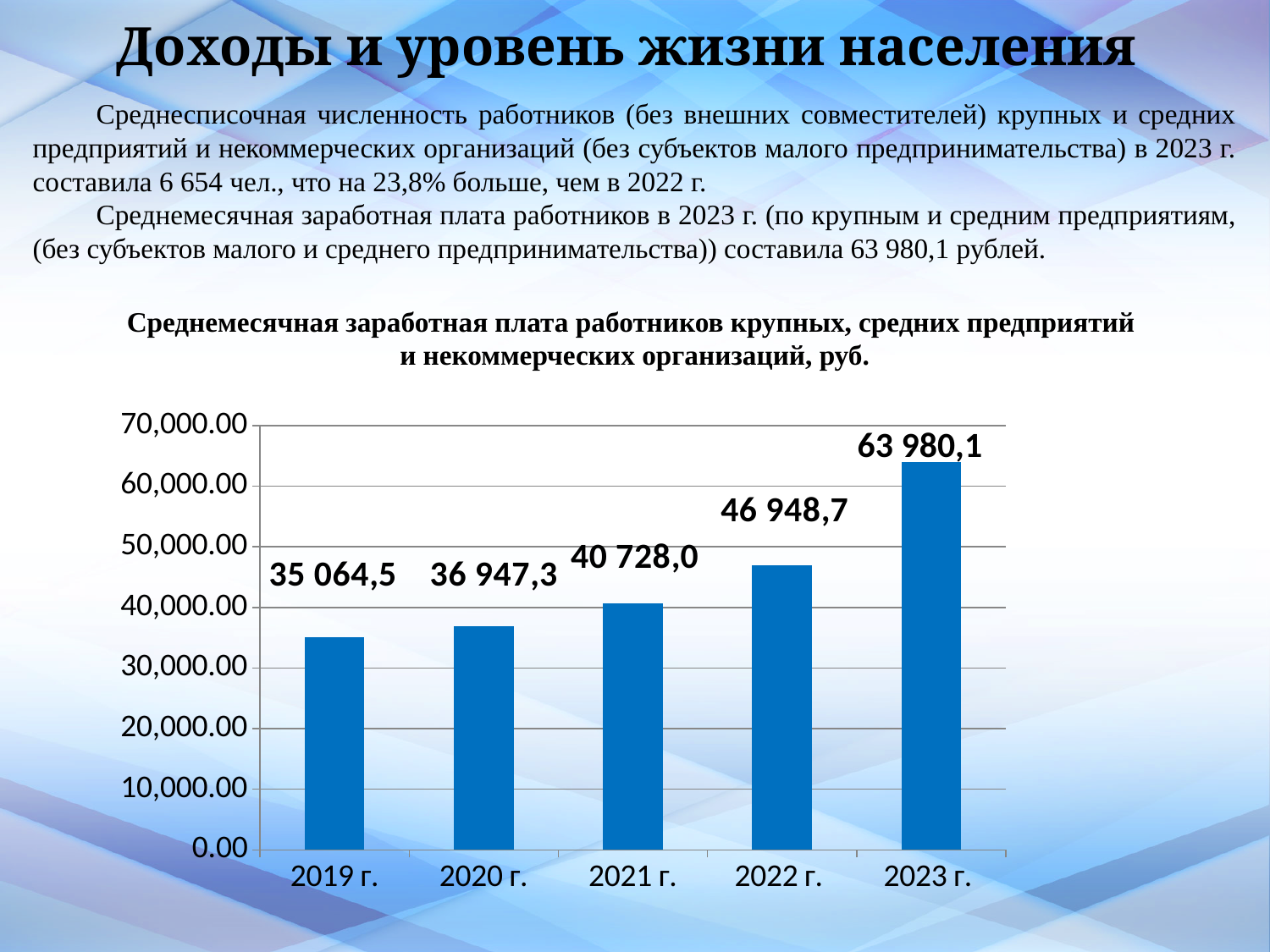
What is the value for 2023 г. in the chart? 63 980,1 What is the value for 2021 г. in the chart? 40 728,0 How many years are shown on the x axis of the chart? 5 What is the difference between the values for 2023 г. and 2022 г.? 17 031,4 What is the difference between the values for 2020 г. and 2019 г.? 1 882,8 Which year has the highest value in the chart? 2023 г. Do the values rise or fall from 2019 г. to 2023 г.? rise Which year has the lowest value in the chart? 2019 г. Is the value for 2022 г. greater or less than 50,000.00? less What is the value for 2019 г. in the chart? 35 064,5 Which is larger, the value for 2022 г. or the value for 2021 г.? 2022 г. What kind of chart is shown on the slide? bar chart